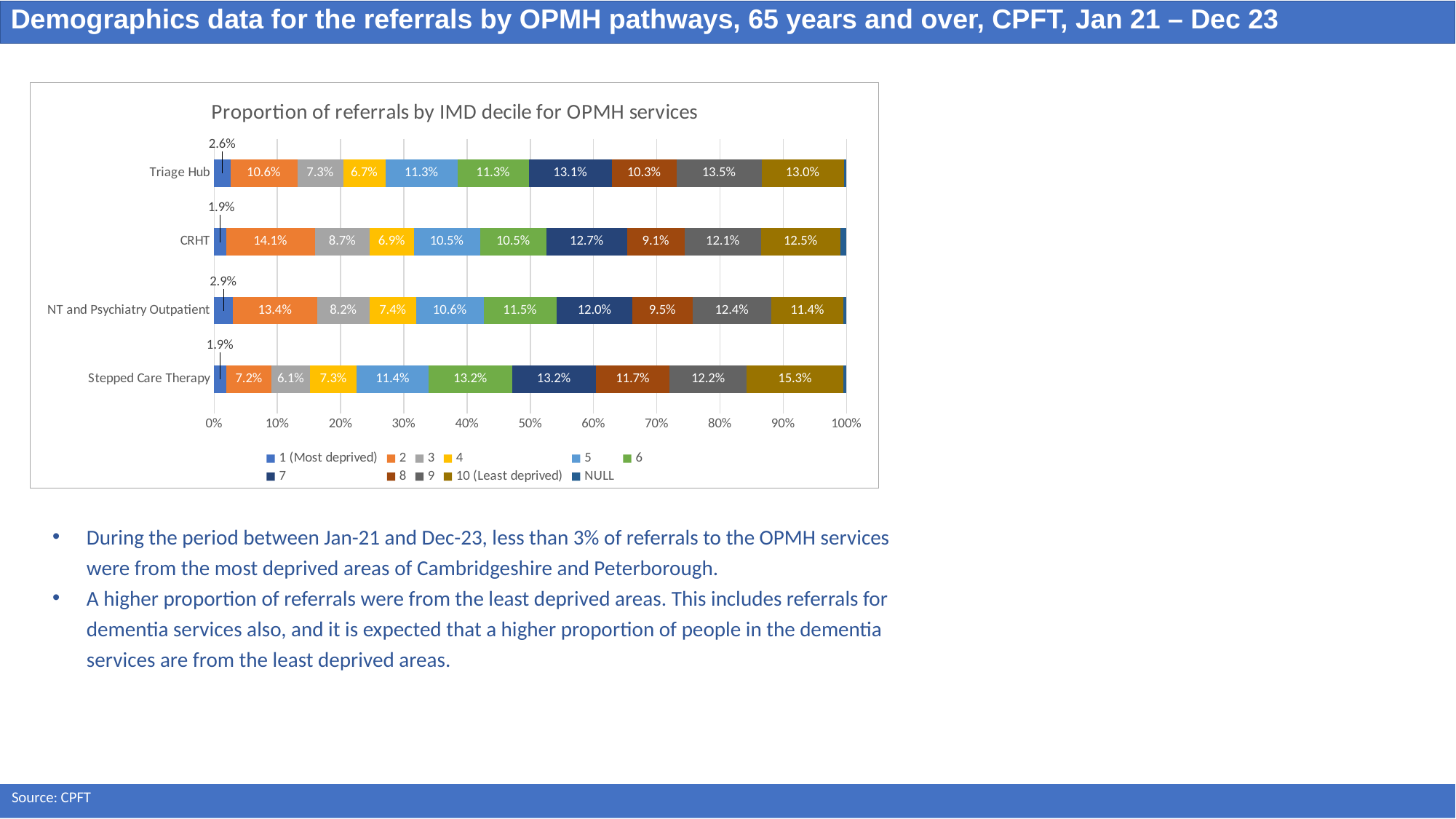
Which service has the lowest proportion of referrals from decile 2? Stepped Care Therapy What is the difference between the decile 10 (Least deprived) values for Stepped Care Therapy and Triage Hub? 2.3% Which service has the highest proportion of referrals from decile 1 (Most deprived)? NT and Psychiatry Outpatient What is the title of the chart? Proportion of referrals by IMD decile for OPMH services What kind of chart is shown on the slide? Stacked bar chart How many series does the legend list? 11 What is the value for decile 2 for CRHT? 14.1% What is the value for decile 1 (Most deprived) for Triage Hub? 2.6% What is the value for decile 7 for NT and Psychiatry Outpatient? 12.0% Which has the larger decile 3 value, CRHT or NT and Psychiatry Outpatient? CRHT What is the value for decile 10 (Least deprived) for Stepped Care Therapy? 15.3% How many services are shown on the chart? 4